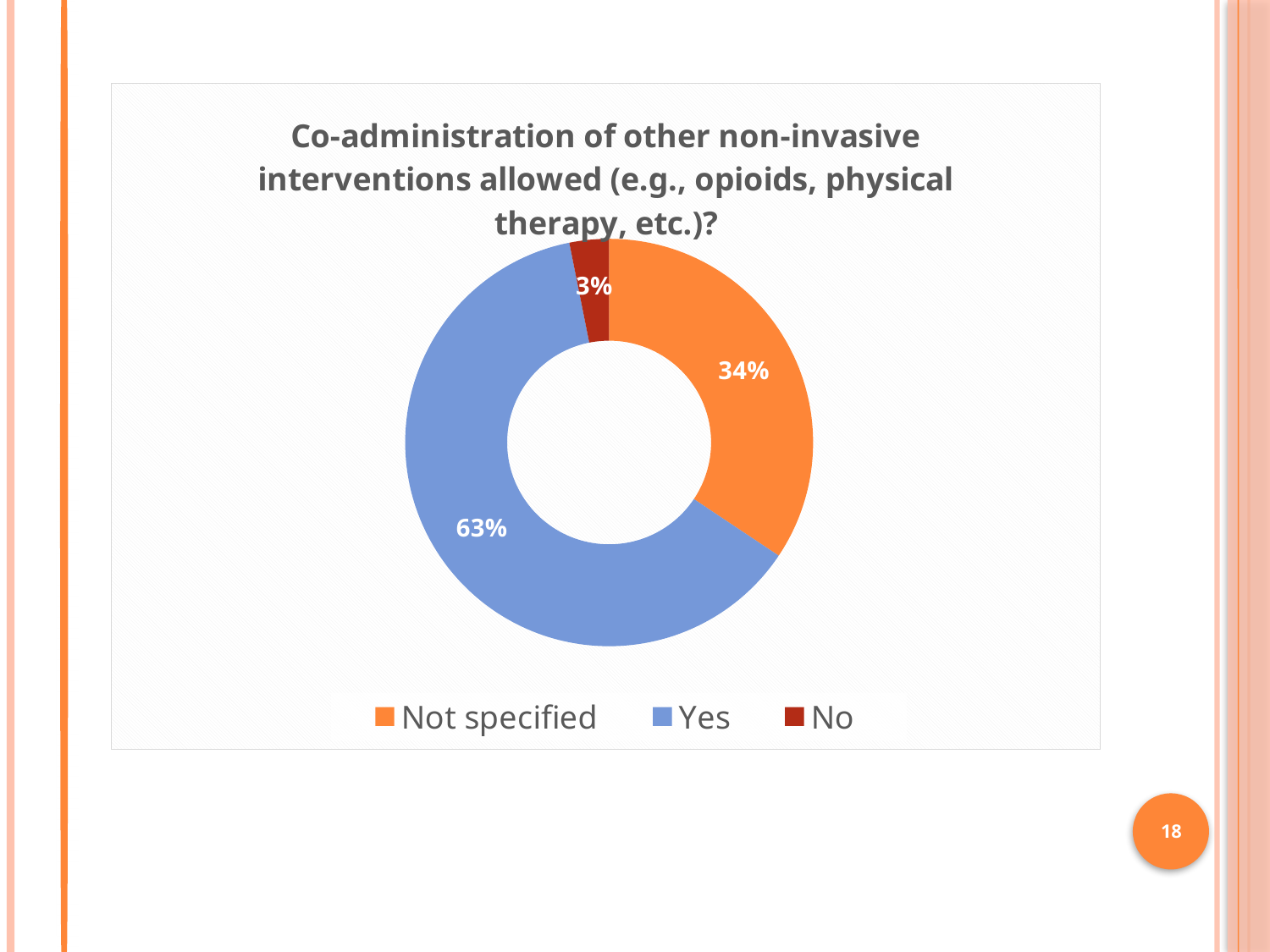
Which slice is larger, "Not specified" or "No"? Not specified Which category has the largest share of the chart? Yes What percentage of the doughnut chart is labelled "Not specified"? 34% What colour is the "Yes" slice? Blue Which category has the smallest share of the chart? No What kind of chart is shown on the slide? Doughnut (pie) chart What percentage of the doughnut chart is labelled "No"? 3% What is the title of the chart? Co-administration of other non-invasive interventions allowed (e.g., opioids, physical therapy, etc.)? How many entries does the legend list? 3 How many categories does the chart show? 3 What percentage of the doughnut chart is labelled "Yes"? 63% What is the difference in percentage points between the "Yes" and "Not specified" slices? 29